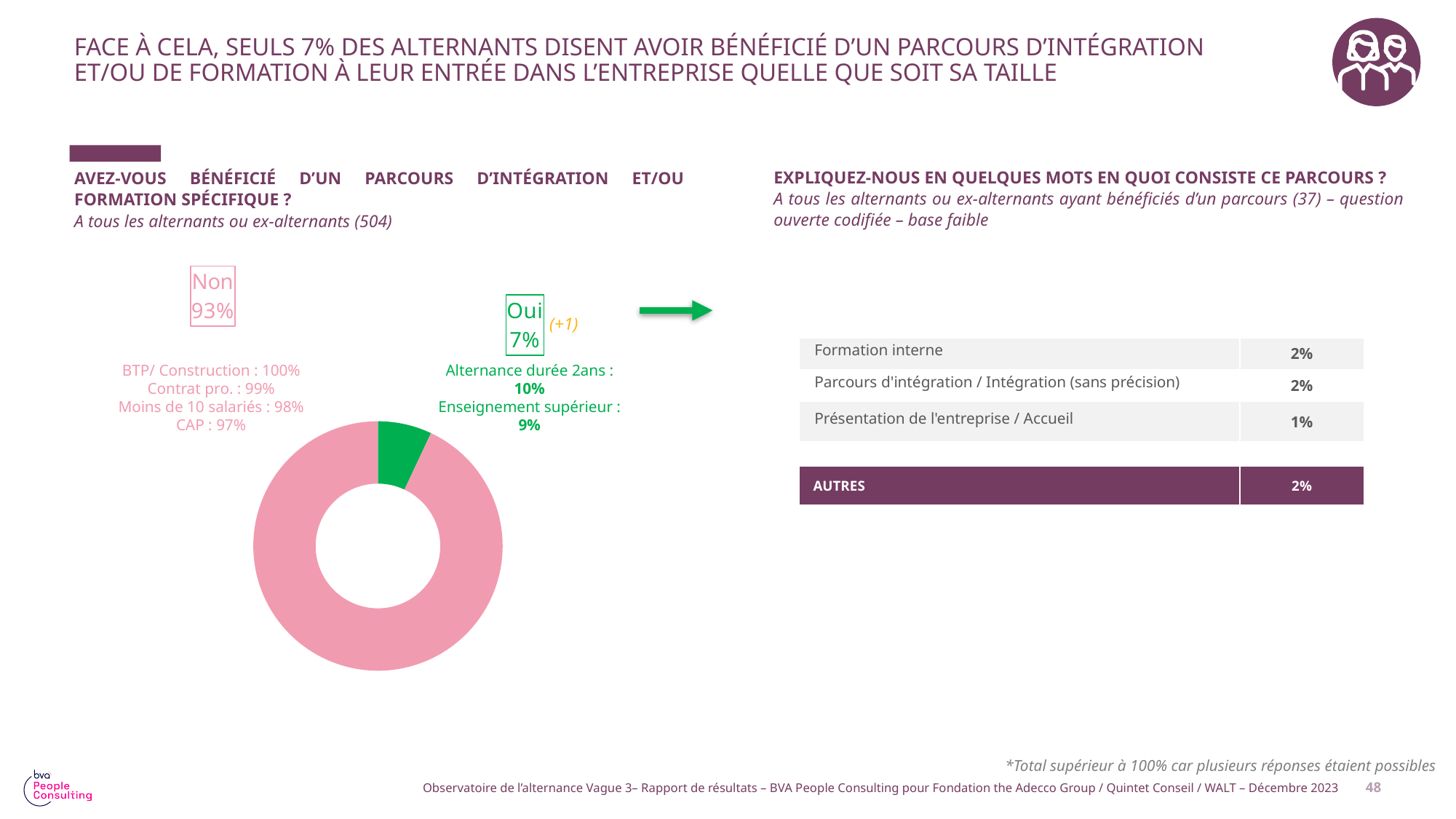
In the donut chart, what percentage of respondents answered "Non"? 93% In the donut chart, what percentage of respondents answered "Oui"? 7% In the donut chart, which is larger: the share for "Oui" or the share for "Non"? Non How many categories does the donut chart show? 2 What share of the donut chart does the "Oui" slice represent? 7% What colour is the "Oui" slice in the donut chart? green What is the difference in percentage points between the "Non" and "Oui" shares in the donut chart? 86 percentage points Which category has the largest share in the donut chart? Non Which category has the smallest share in the donut chart? Oui What do the two slices of the donut chart add up to? 100% What colour is the "Non" slice in the donut chart? pink What kind of chart is used to show the Oui/Non split on the slide? pie chart (donut)